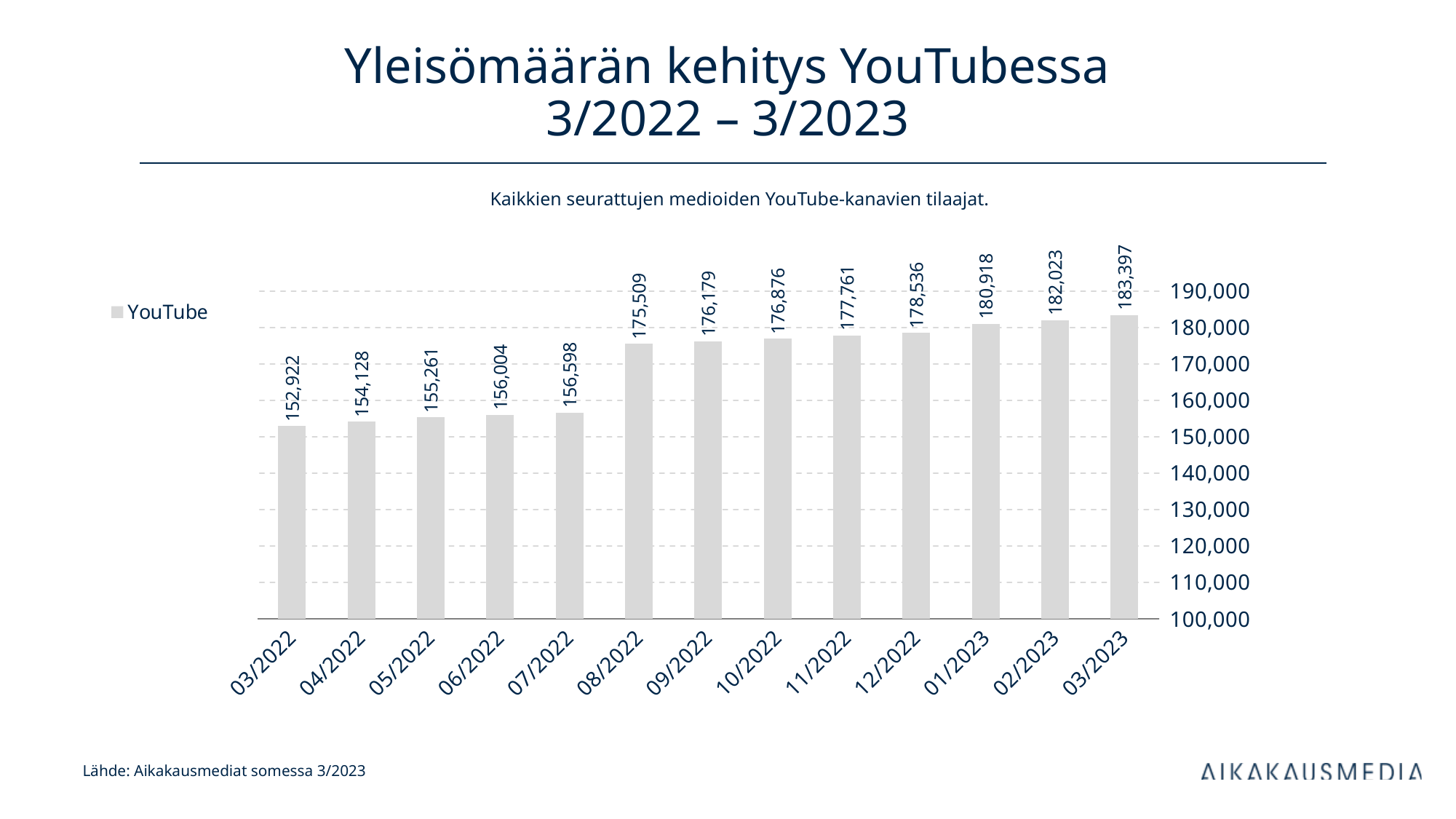
Which is larger, the value for 06/2022 or the value for 10/2022? 10/2022 Do the values rise or fall from 03/2022 to 03/2023? rise Which month has the lowest value? 03/2022 What is the value for 08/2022? 175,509 What is the value for 12/2022? 178,536 How many months are shown on the x axis? 13 Which month has the highest value? 03/2023 What is the difference between the values for 08/2022 and 07/2022? 18,911 Is the value for 05/2022 greater or less than 160,000? less What kind of chart is shown on the slide? bar chart What is the difference between the values for 03/2023 and 03/2022? 30,475 What is the value for 03/2022? 152,922